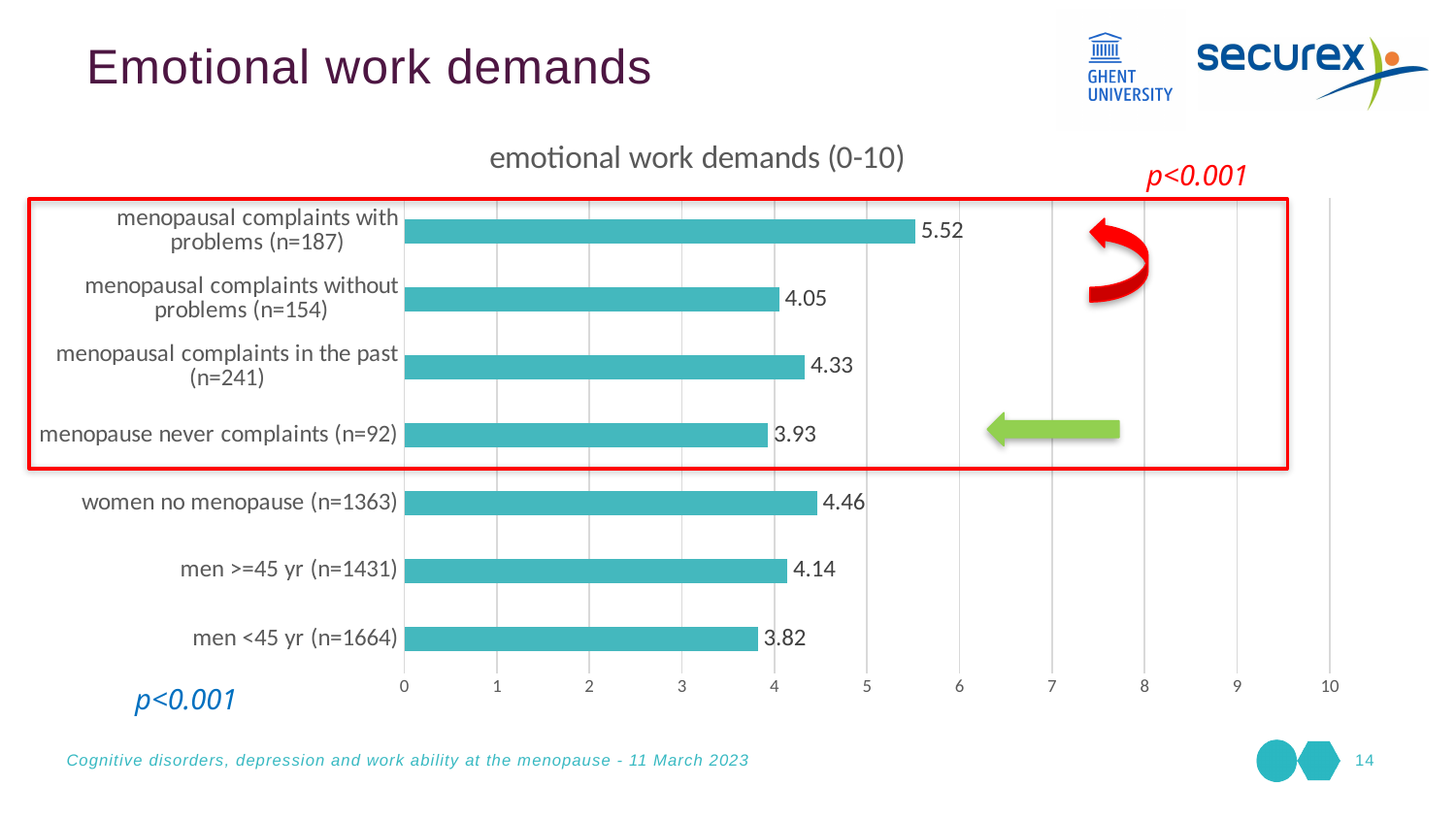
Which category has the lowest emotional work demands value? men <45 yr (n=1664) What is the difference between the values for menopausal complaints with problems (n=187) and menopausal complaints without problems (n=154)? 1.47 Is the value for menopausal complaints with problems (n=187) greater or less than 5? greater What is the emotional work demands value for men <45 yr (n=1664)? 3.82 What is the value for women no menopause (n=1363)? 4.46 How many categories are shown in the chart? 7 Which is larger: the value for menopausal complaints in the past (n=241) or the value for men >=45 yr (n=1431)? menopausal complaints in the past (n=241) What kind of chart is shown on the slide? bar chart What is the title of the chart? emotional work demands (0-10) Which category has the highest emotional work demands value? menopausal complaints with problems (n=187) What is the emotional work demands value for menopausal complaints with problems (n=187)? 5.52 What is the value for menopause never complaints (n=92)? 3.93